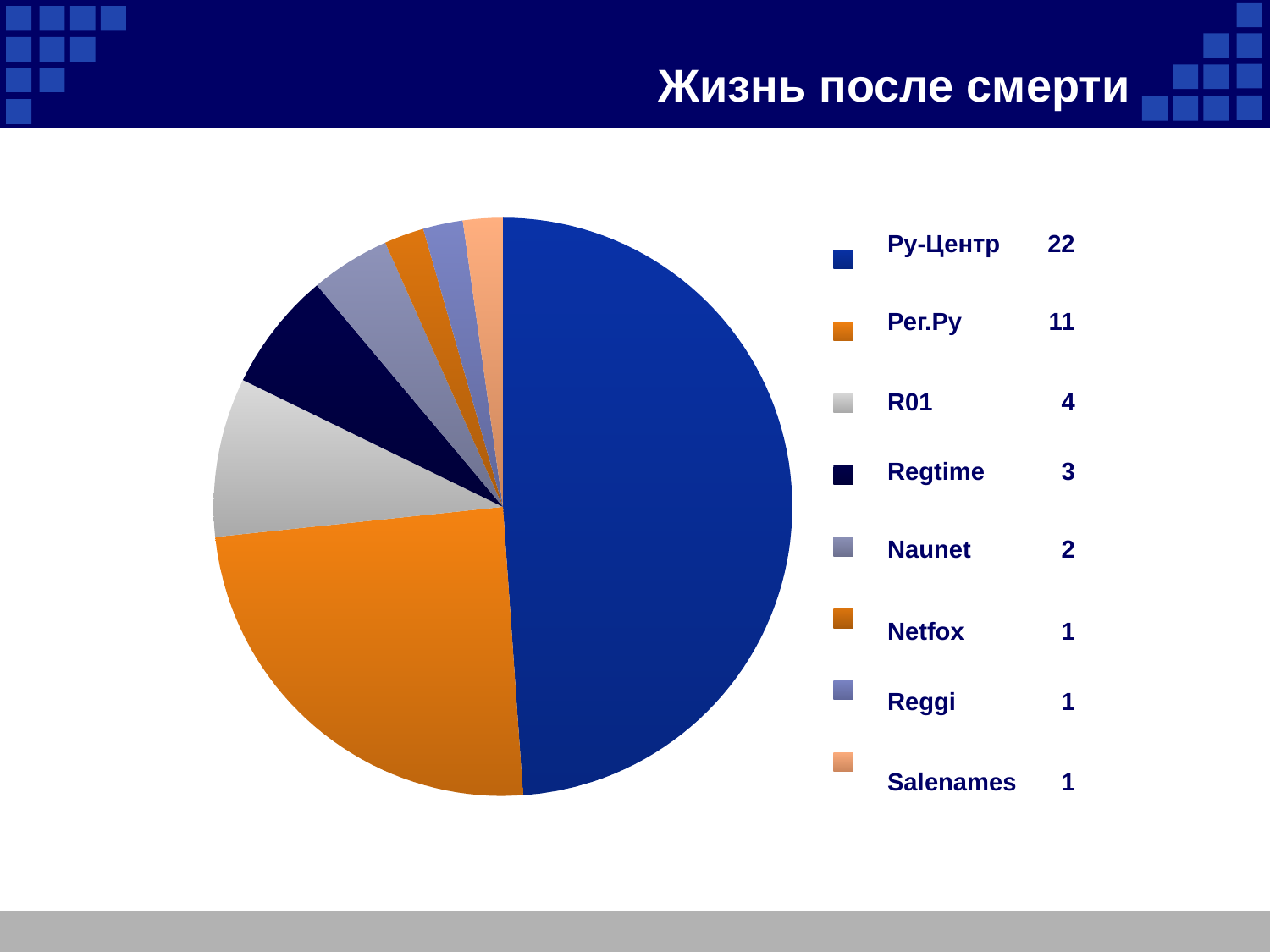
What is the difference between the values for Ру-Центр and Рег.Ру? 11 What is the title of the slide? Жизнь после смерти Which category has the largest slice of the pie? Ру-Центр What is the value for Рег.Ру? 11 What kind of chart is shown on the slide? pie chart Which is larger, the value for R01 or the value for Regtime? R01 What is the difference between the values for Naunet and Netfox? 1 What is the value for R01? 4 What is the value for Ру-Центр? 22 How many categories does the legend list? 8 What is the total of all the values shown in the legend? 45 What is the value for Regtime? 3